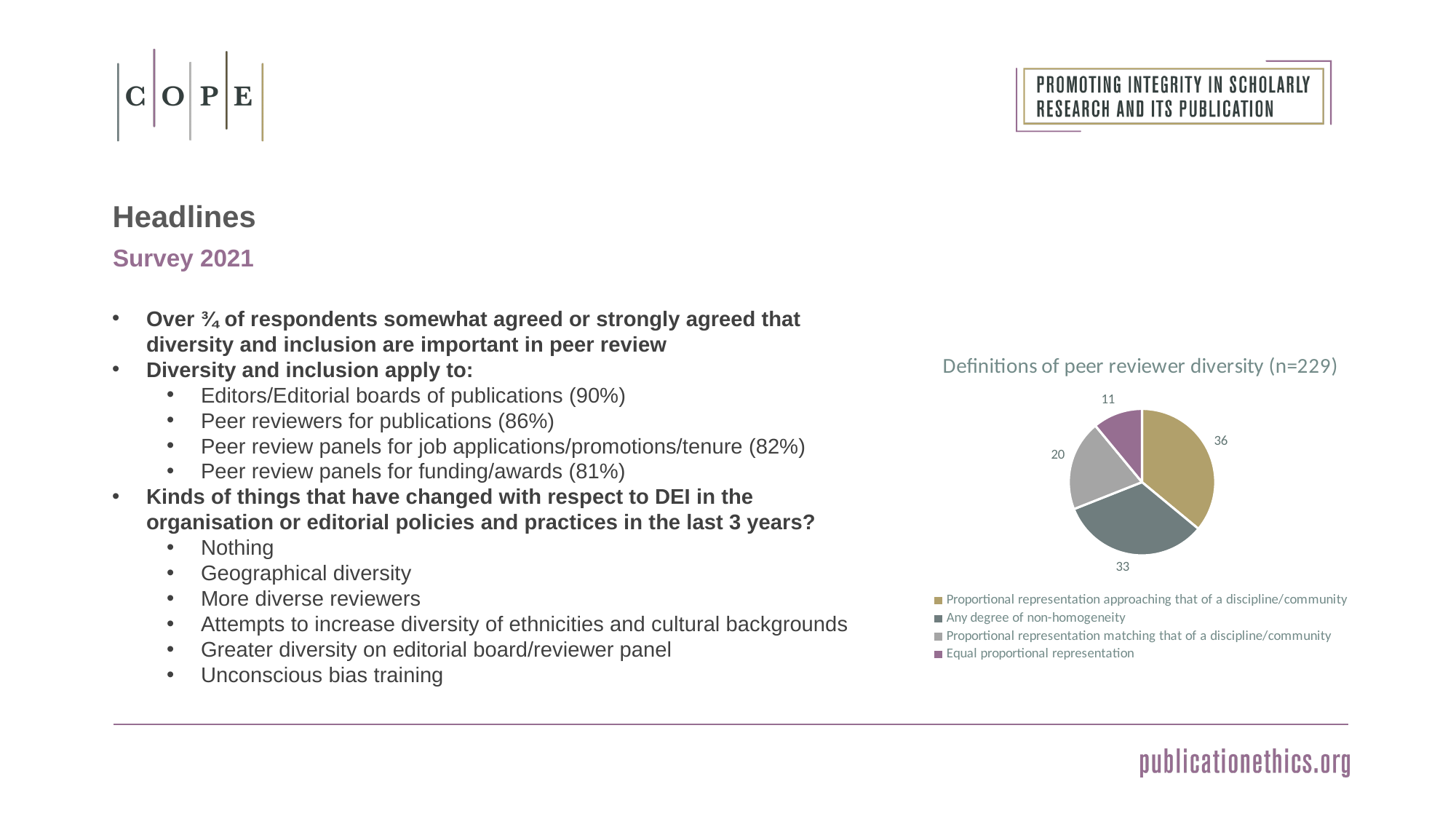
Which category has the largest slice of the pie? Proportional representation approaching that of a discipline/community What is the value for 'Equal proportional representation'? 11 Which is larger: 'Any degree of non-homogeneity' or 'Proportional representation matching that of a discipline/community'? Any degree of non-homogeneity What is the value for 'Proportional representation approaching that of a discipline/community'? 36 What is the value for 'Proportional representation matching that of a discipline/community'? 20 How many categories does the legend list? 4 What is the title of the chart? Definitions of peer reviewer diversity (n=229) What is the difference between the values for 'Proportional representation approaching that of a discipline/community' and 'Equal proportional representation'? 25 What share of the pie does 'Equal proportional representation' represent? 11% What type of chart is shown on the slide? pie chart What is the value for 'Any degree of non-homogeneity'? 33 Which category has the smallest slice of the pie? Equal proportional representation